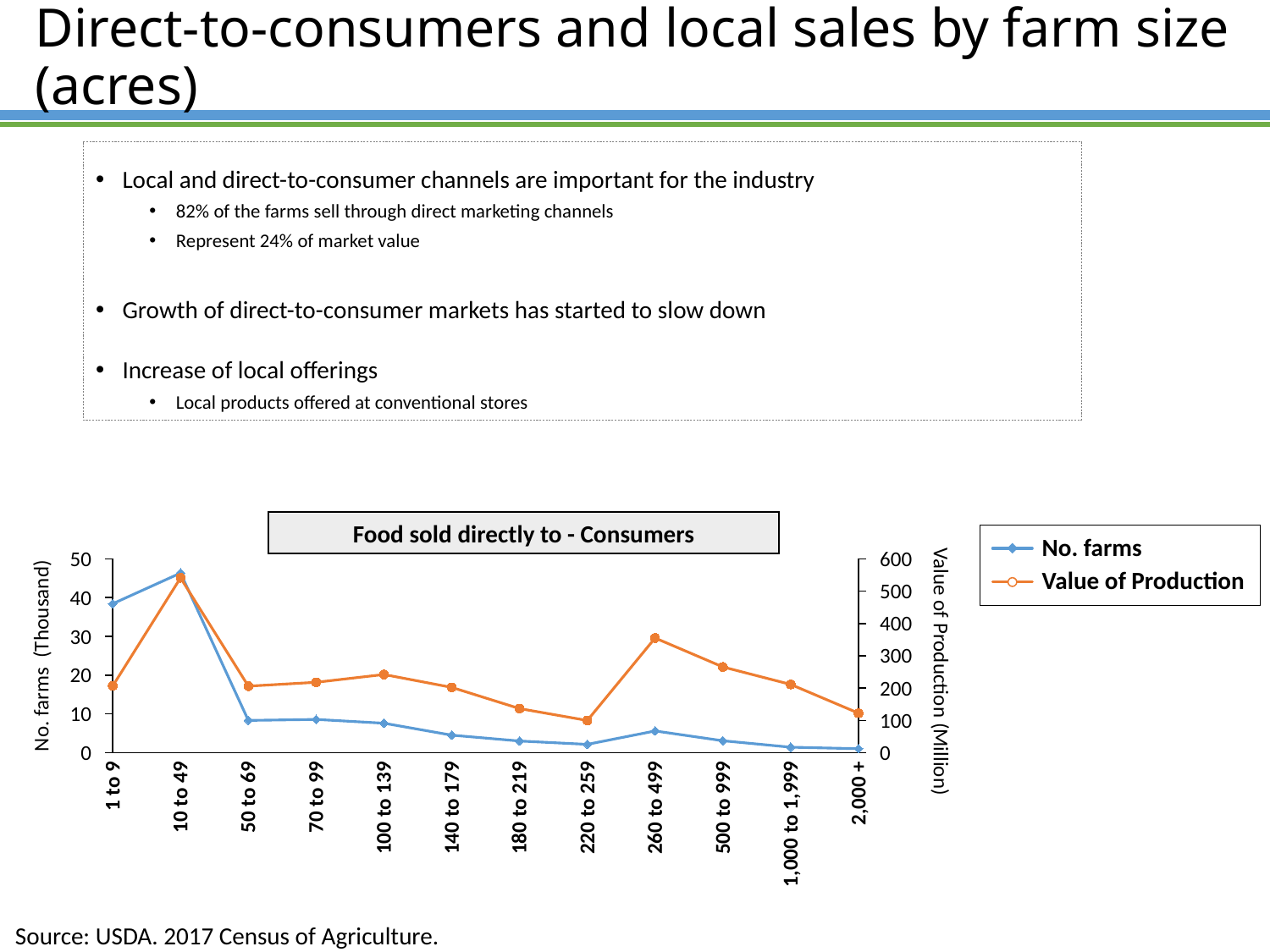
Which has a larger No. farms value: the 1 to 9 category or the 50 to 69 category? 1 to 9 Is the Value of Production for the 1 to 9 category greater or less than 300? less Is the No. farms value for the 1 to 9 category greater or less than 30? greater Is the Value of Production for the 260 to 499 category greater or less than 300? greater What is the title of the chart? Food sold directly to - Consumers Which farm size category has the highest Value of Production? 10 to 49 How many farm size categories are plotted along the x axis of the chart? 12 Do the No. farms values rise or fall from the 260 to 499 category to the 2,000 + category? fall What kind of chart is shown on the slide? Line chart Which farm size category has the highest value for No. farms? 10 to 49 Which farm size category has the lowest value for No. farms? 2,000 + How many series does the legend of the chart list? 2